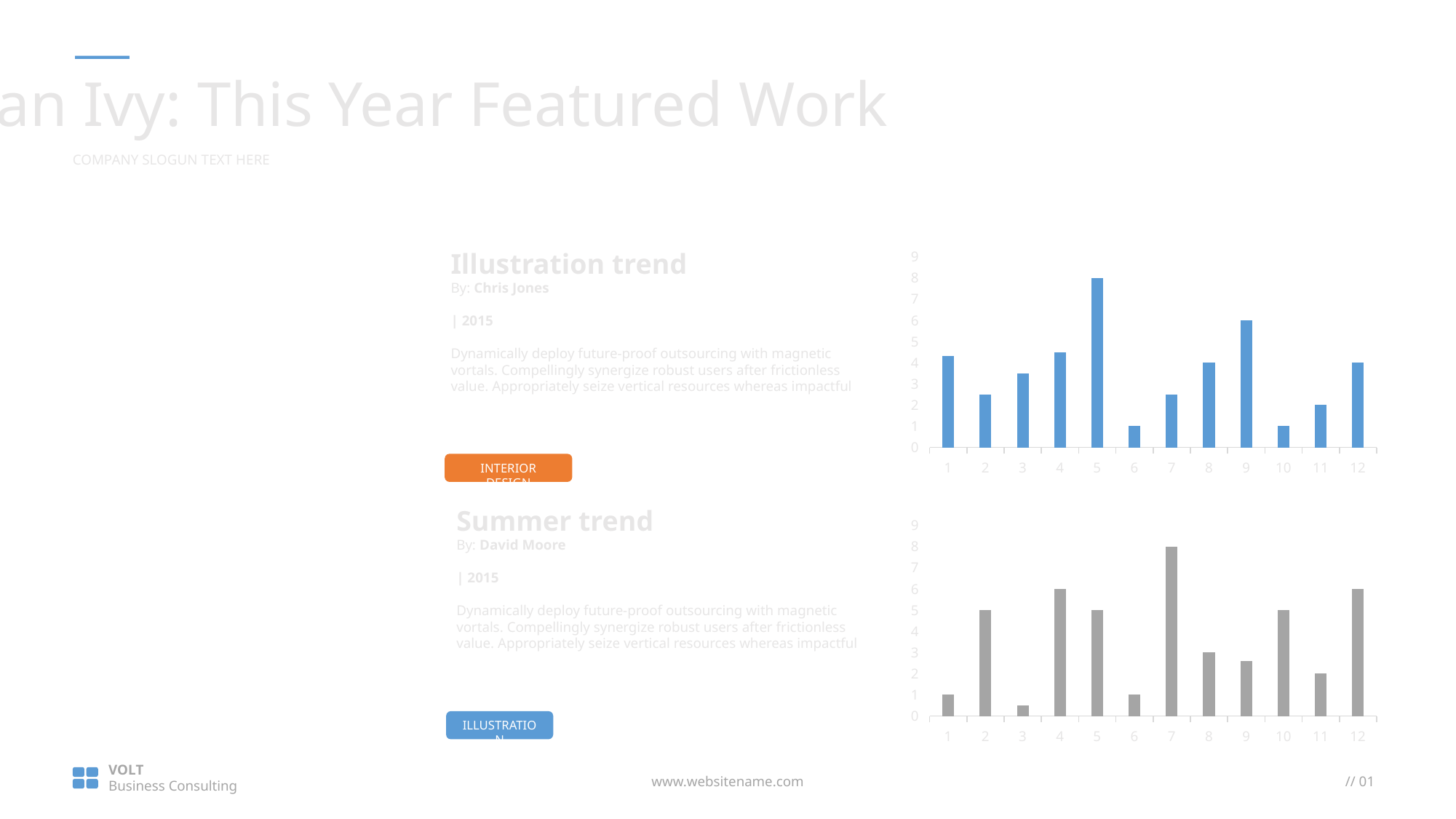
In the bottom chart, which category has the highest bar? 7 What kind of chart is the top chart on the slide? bar chart In the top chart, is the value for category 6 greater or less than 2? less What kind of chart is the bottom chart on the slide? bar chart In the bottom chart, which is larger, the value for category 4 or the value for category 8? category 4 In the top chart, which is larger, the value for category 9 or the value for category 2? category 9 In the top chart, which category has the highest bar? 5 In the bottom chart, is the value for category 7 greater or less than 7? greater In the top chart, is the value for category 5 greater or less than 7? greater How many categories are shown on the x axis of the top chart? 12 In the bottom chart, which category has the lowest bar? 3